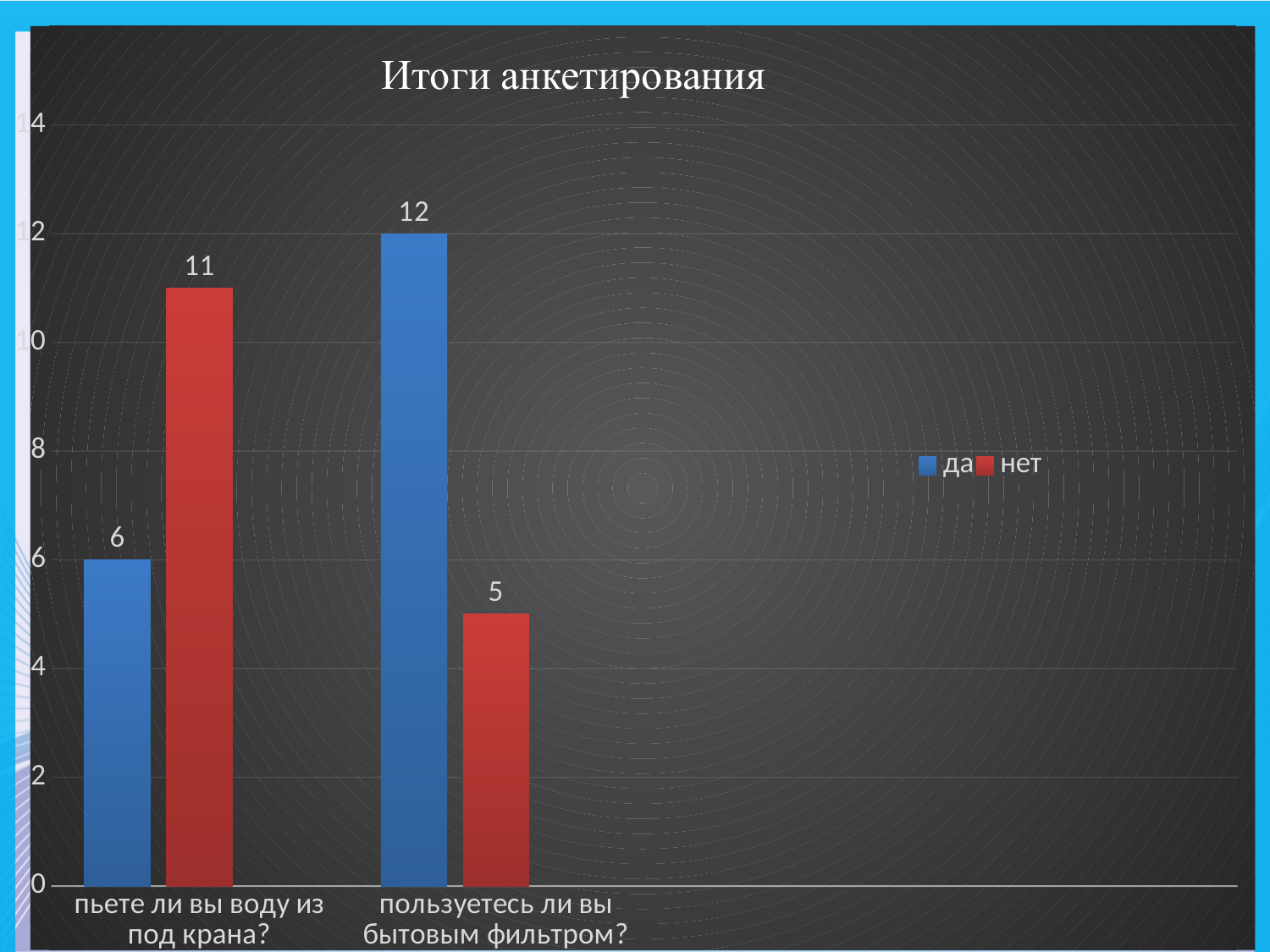
Which bar has the highest value on the chart? да, пользуетесь ли вы бытовым фильтром? Which bar has the lowest value on the chart? нет, пользуетесь ли вы бытовым фильтром? How many categories are shown on the x axis? 2 What is the value for "нет" in the category "пользуетесь ли вы бытовым фильтром?"? 5 What is the difference between "да" and "нет" for "пользуетесь ли вы бытовым фильтром?"? 7 Which is larger for "пьете ли вы воду из под крана?": "да" or "нет"? нет What is the title of the chart? Итоги анкетирования What is the value for "нет" in the category "пьете ли вы воду из под крана?"? 11 What is the difference between "нет" and "да" for "пьете ли вы воду из под крана?"? 5 What is the value for "да" in the category "пользуетесь ли вы бытовым фильтром?"? 12 What is the value for "да" in the category "пьете ли вы воду из под крана?"? 6 How many series does the legend list? 2